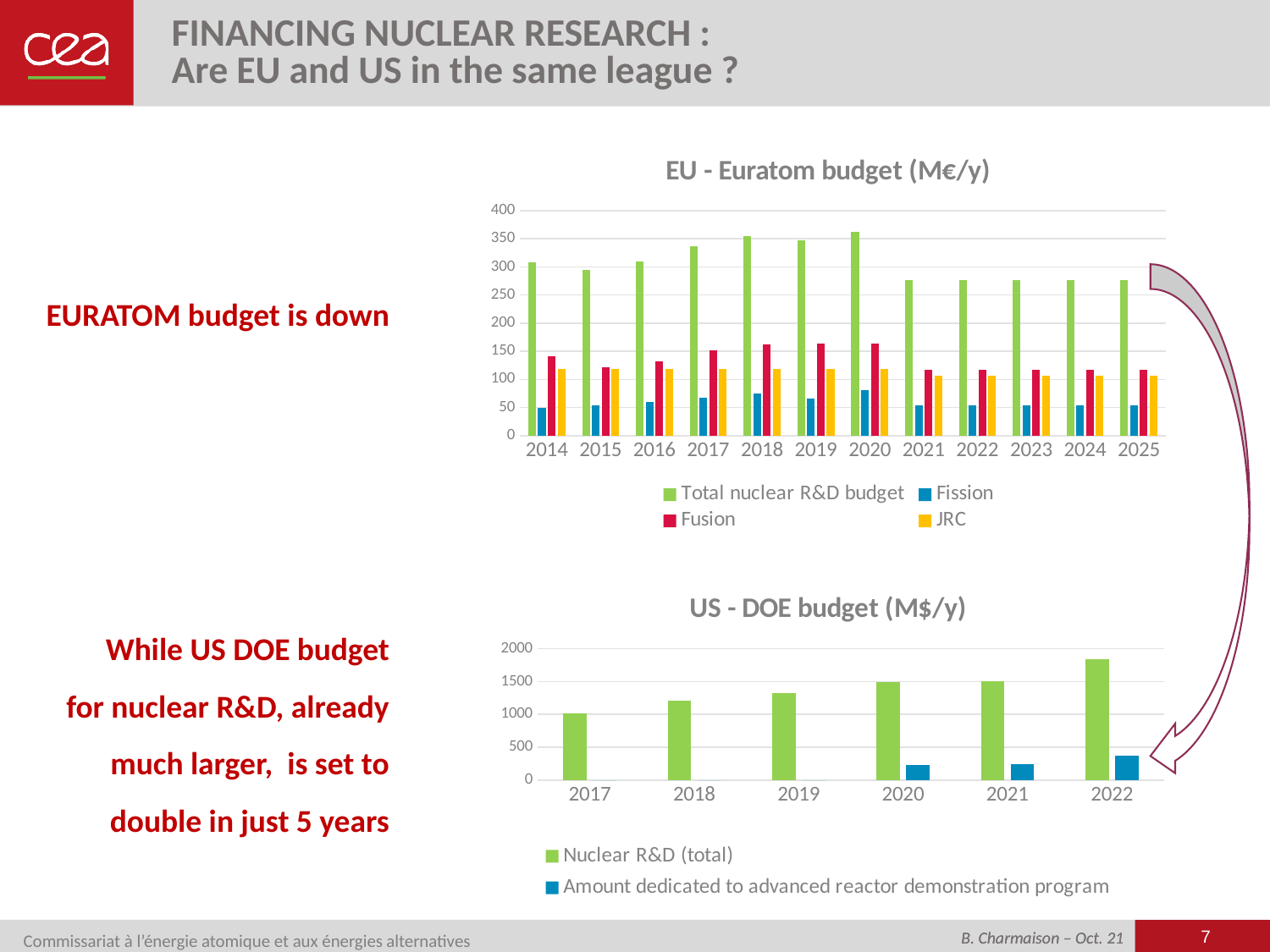
On the US - DOE budget chart, which year has the lowest Nuclear R&D (total) value? 2017 On the EU - Euratom budget chart, how many series does the legend list? 4 On the EU - Euratom budget chart, which year has the highest Total nuclear R&D budget? 2020 On the US - DOE budget chart, is the Nuclear R&D (total) value for 2022 greater or less than 1500? greater On the EU - Euratom budget chart, is the Fusion value for 2019 greater or less than 150? greater On the EU - Euratom budget chart, is the Fission value for 2014 greater or less than 100? less On the US - DOE budget chart, does the Nuclear R&D (total) value rise or fall from 2017 to 2022? rise On the EU - Euratom budget chart, how many years are shown on the x axis? 12 On the EU - Euratom budget chart, which is larger in 2020: the Fission value or the Fusion value? Fusion On the US - DOE budget chart, which year has the highest Nuclear R&D (total) value? 2022 What kind of chart is the US - DOE budget chart? bar chart